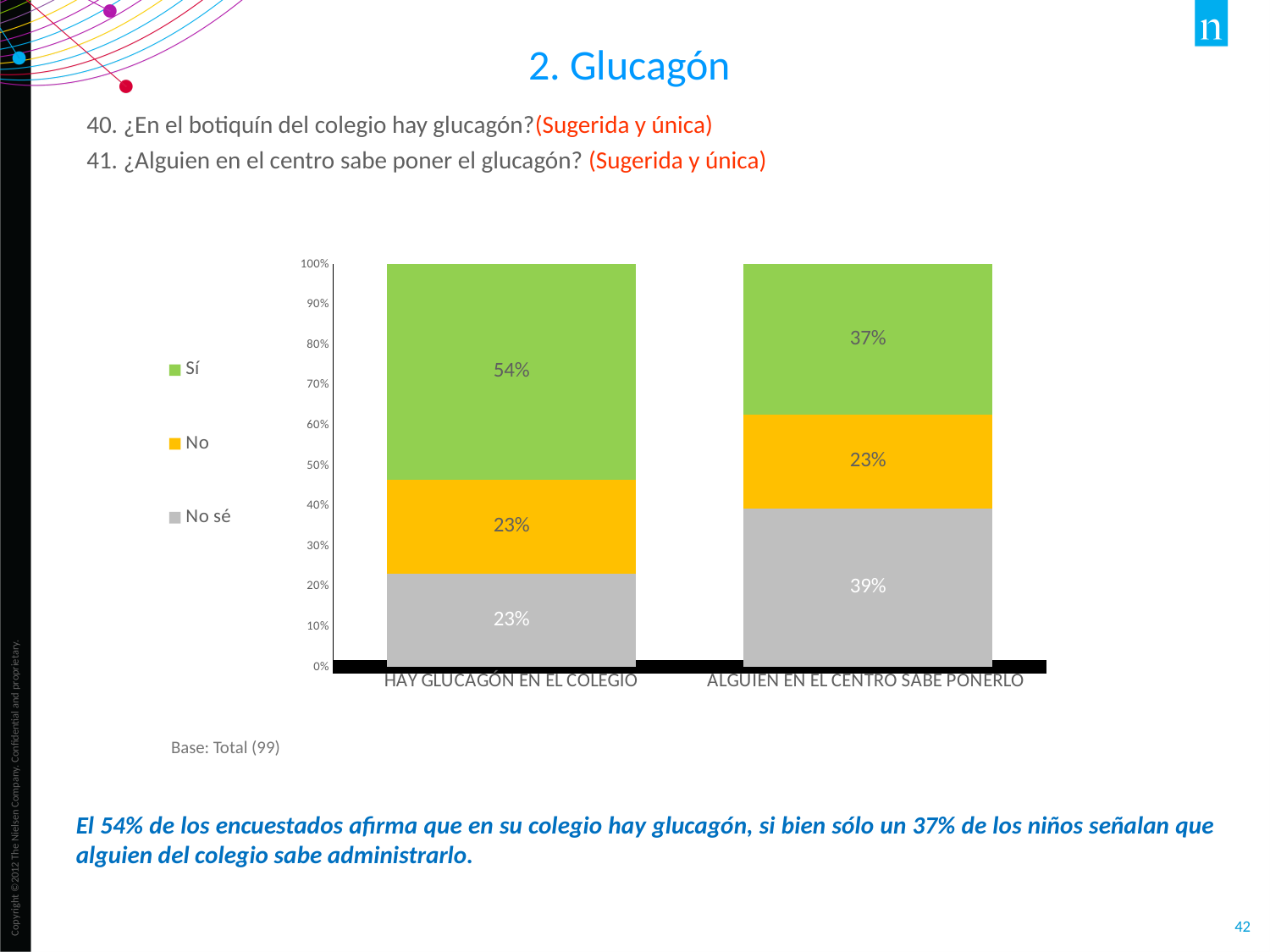
How many categories are shown on the x axis of the chart? 2 How many series does the chart legend list? 3 What percentage answered "Sí" for "HAY GLUCAGÓN EN EL COLEGIO"? 54% What percentage answered "No sé" for "ALGUIEN EN EL CENTRO SABE PONERLO"? 39% What percentage answered "No" for "HAY GLUCAGÓN EN EL COLEGIO"? 23% Which category has the higher "Sí" percentage? HAY GLUCAGÓN EN EL COLEGIO Which colour represents "No" in the chart legend? Yellow What type of chart is shown on the slide? Stacked bar chart What percentage answered "Sí" for "ALGUIEN EN EL CENTRO SABE PONERLO"? 37% Which response has the largest share in the "ALGUIEN EN EL CENTRO SABE PONERLO" bar? No sé What is the difference between the "Sí" percentages for "HAY GLUCAGÓN EN EL COLEGIO" and "ALGUIEN EN EL CENTRO SABE PONERLO"? 17% What is the difference between the "No sé" percentages for "ALGUIEN EN EL CENTRO SABE PONERLO" and "HAY GLUCAGÓN EN EL COLEGIO"? 16%